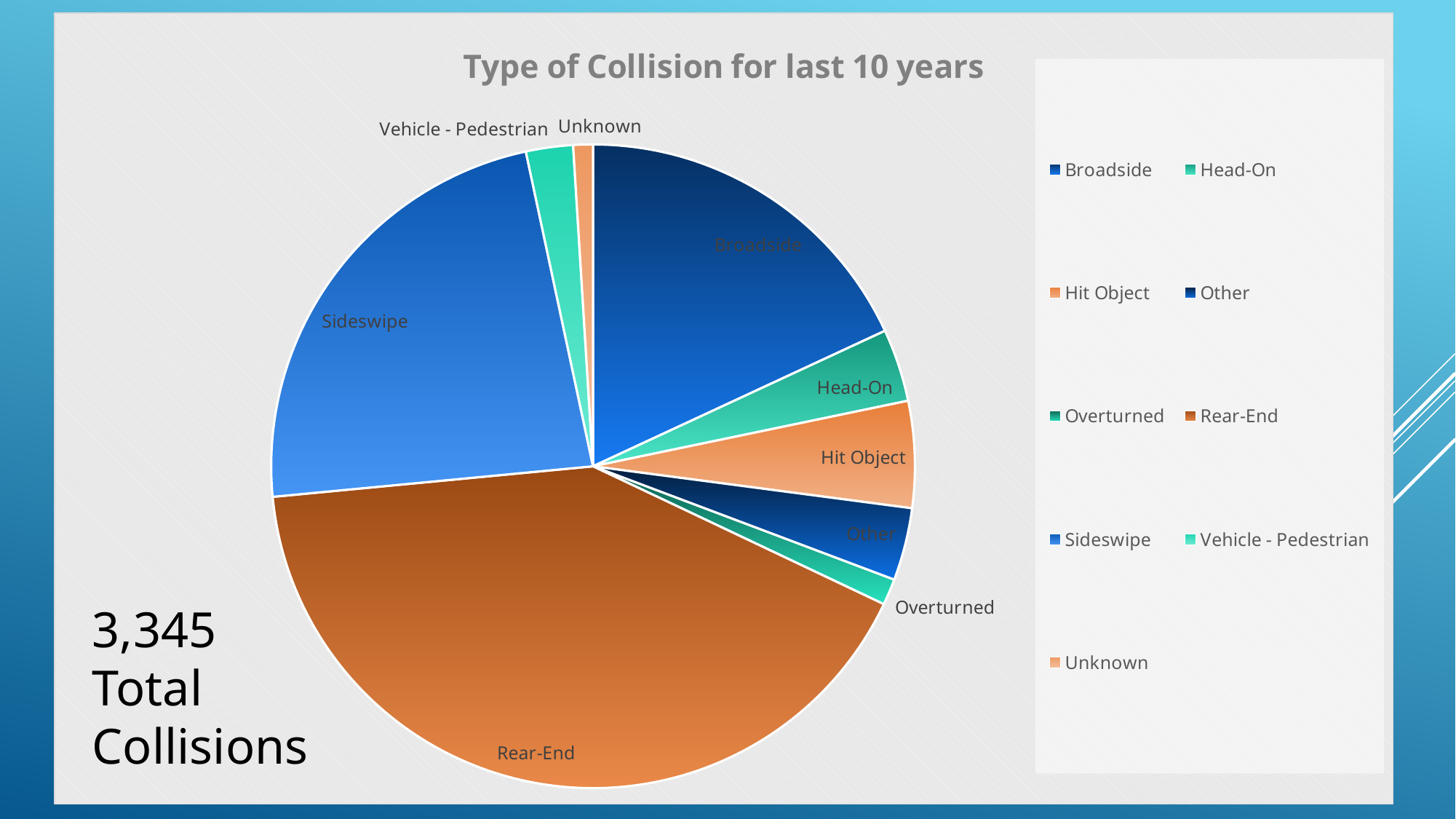
Which slice is larger, Sideswipe or Broadside? Sideswipe Which slice is larger, Vehicle - Pedestrian or Unknown? Vehicle - Pedestrian According to the text on the slide, how many total collisions are represented? 3,345 Which slice is larger, Rear-End or Sideswipe? Rear-End Which collision type has the smallest slice of the pie? Unknown Which collision type has the second-largest slice of the pie? Sideswipe Which collision type has the largest slice of the pie? Rear-End How many entries does the legend list? 9 What kind of chart is shown on the slide? pie chart What is the title of the chart? Type of Collision for last 10 years How many collision types (slices) does the pie chart show? 9